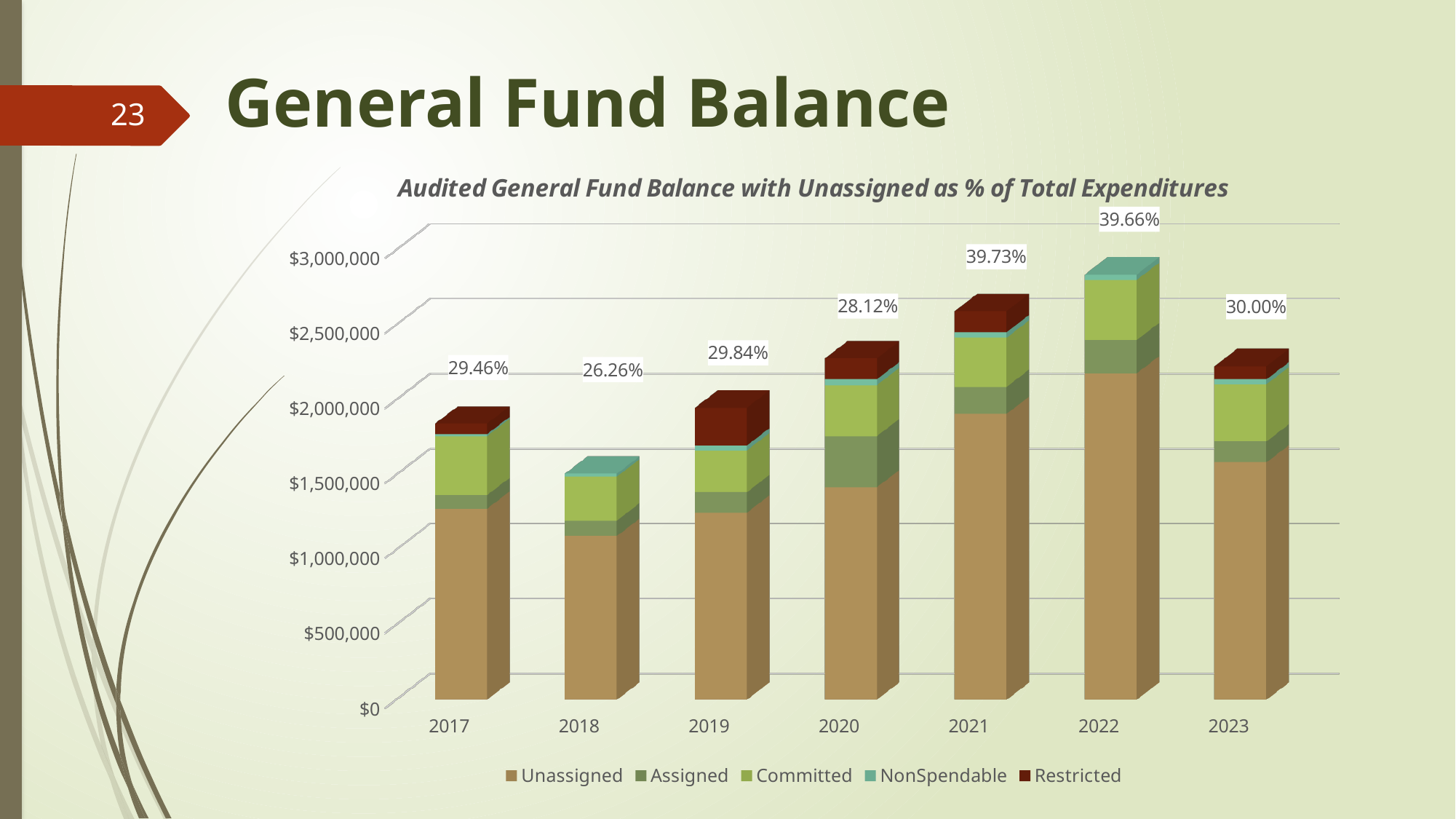
What is the Unassigned as % of Total Expenditures label shown for 2021? 39.73% How many series does the chart legend list? 5 What percentage label is shown above the 2018 bar? 26.26% Which is larger, the percentage label for 2019 or for 2020? 2019 What is the difference between the percentage labels for 2023 and 2018? 3.74 percentage points Which year has the tallest total fund balance bar? 2022 Which year has the shortest total fund balance bar? 2018 What percentage label is shown above the 2023 bar? 30.00% Which year has the lowest Unassigned as % of Total Expenditures label? 2018 How many years are shown on the x axis of the chart? 7 Is the total fund balance bar for 2018 greater or less than $2,000,000? less Is the total fund balance bar for 2022 greater or less than $2,500,000? greater